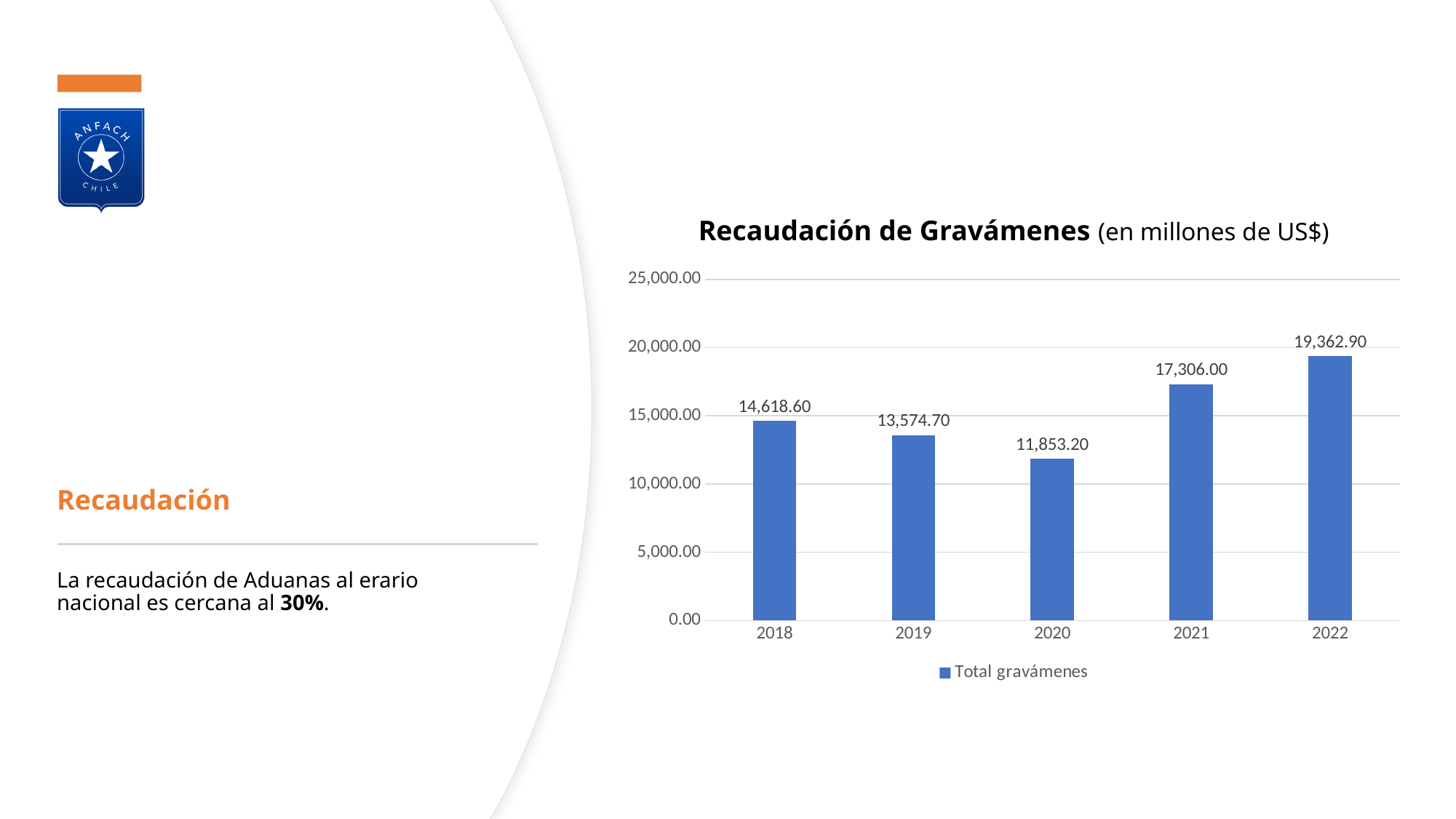
How many series does the legend list? 1 Is the value for 2021 greater or less than 15,000.00? greater What is the difference between the values for 2022 and 2021? 2,056.90 Which year has the lowest value? 2020 What is the value for 2020? 11,853.20 Which year has the highest value? 2022 What is the legend entry of the chart? Total gravámenes How many years are shown on the x axis? 5 Which is larger, the value for 2018 or the value for 2019? 2018 What kind of chart is shown? bar chart What is the value for 2018? 14,618.60 What is the value for 2022? 19,362.90